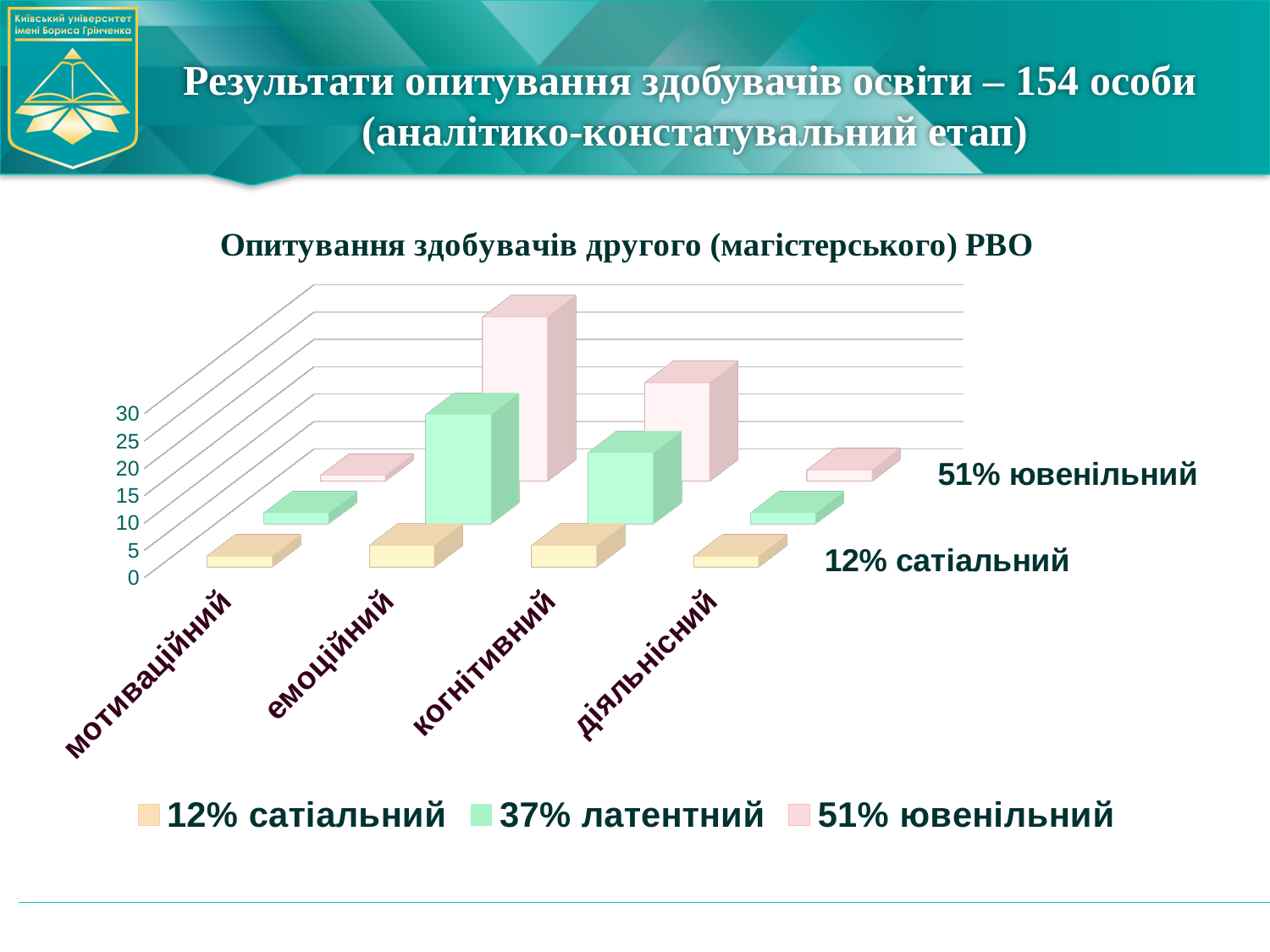
For the series 51% ювенільний, which is larger: емоційний or когнітивний? емоційний Which category has the highest value for the series 51% ювенільний? емоційний Is the value for емоційний in the series 37% латентний greater or less than 10? greater What kind of chart is shown on the slide? bar chart Which category has the highest value for the series 37% латентний? емоційний How many categories are shown on the x axis of the chart? 4 Is the value for діяльнісний in the series 12% сатіальний greater or less than 5? less How many series does the chart legend list? 3 Which legend entry is shown in green? 37% латентний What is the title of the chart? Опитування здобувачів другого (магістерського) РВО Is the value for мотиваційний in the series 51% ювенільний greater or less than 10? less For the series 37% латентний, which is larger: емоційний or діяльнісний? емоційний